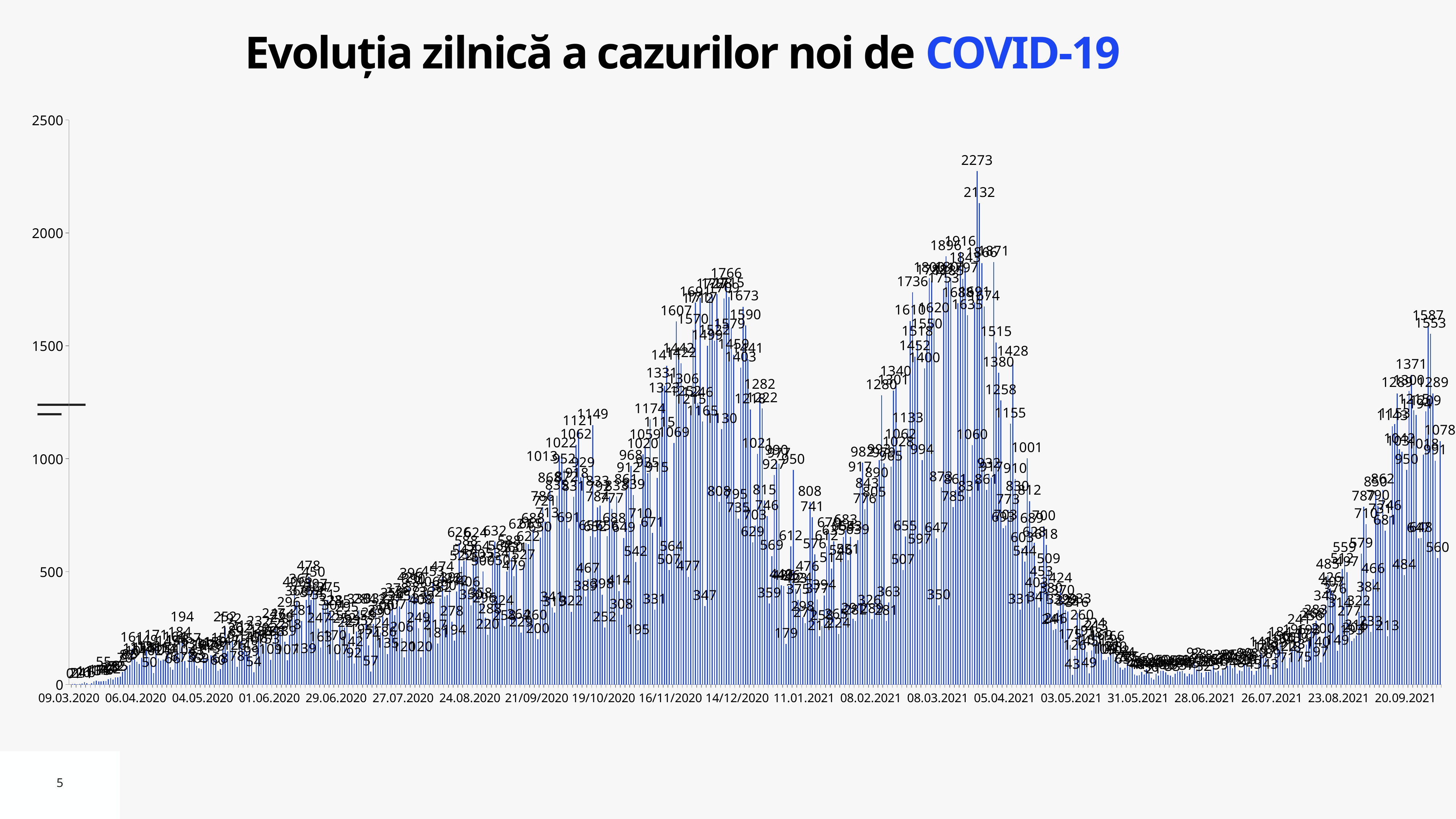
What is the first date label on the x axis? 09.03.2020 What is the highest value shown on the y axis? 2500 What is the highest daily value labelled on the chart? 2273 Is the highest bar on the chart greater or less than 2000? greater What is the last date label on the x axis? 20.09.2021 What kind of chart is shown on the slide? bar chart What is the title of the chart? Evoluția zilnică a cazurilor noi de COVID-19 Between 26.07.2021 and 20.09.2021, do the values generally rise or fall? rise Between 03.05.2021 and 31.05.2021, do the values generally rise or fall? fall Which x-axis date label is nearest to the highest bar on the chart? 05.04.2021 What is the second highest daily value labelled on the chart? 2132 What is the difference between the two highest labelled values, 2273 and 2132? 141